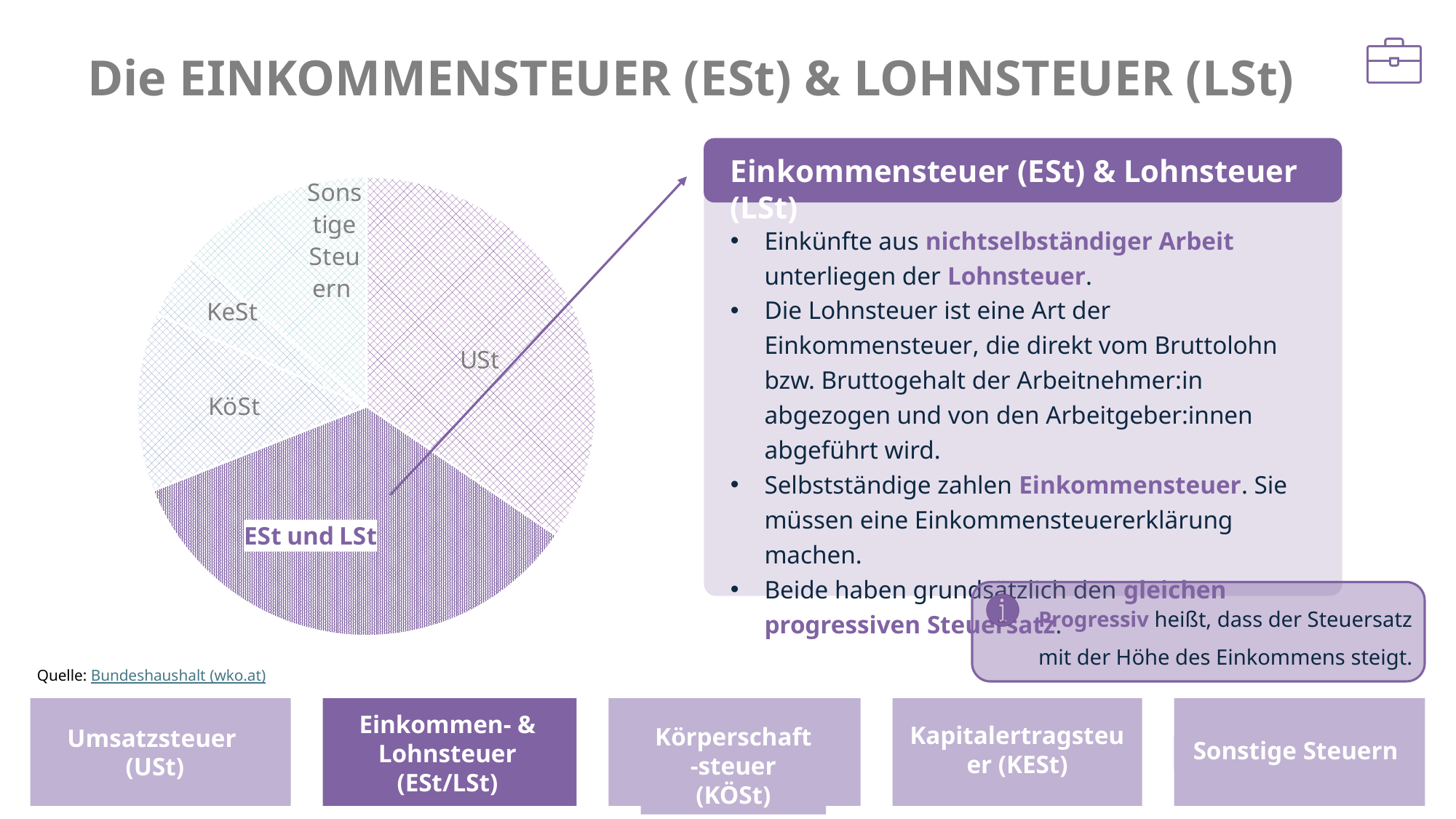
How many slices does the pie chart have? 5 Which is larger in the pie chart, the ESt und LSt slice or the KöSt slice? ESt und LSt What source is cited for the pie chart? Bundeshaushalt (wko.at) Which is larger in the pie chart, the USt slice or the KöSt slice? USt Which is larger in the pie chart, the ESt und LSt slice or the KeSt slice? ESt und LSt What kind of chart is shown on the slide? pie chart Which slice of the pie chart is highlighted in solid purple? ESt und LSt